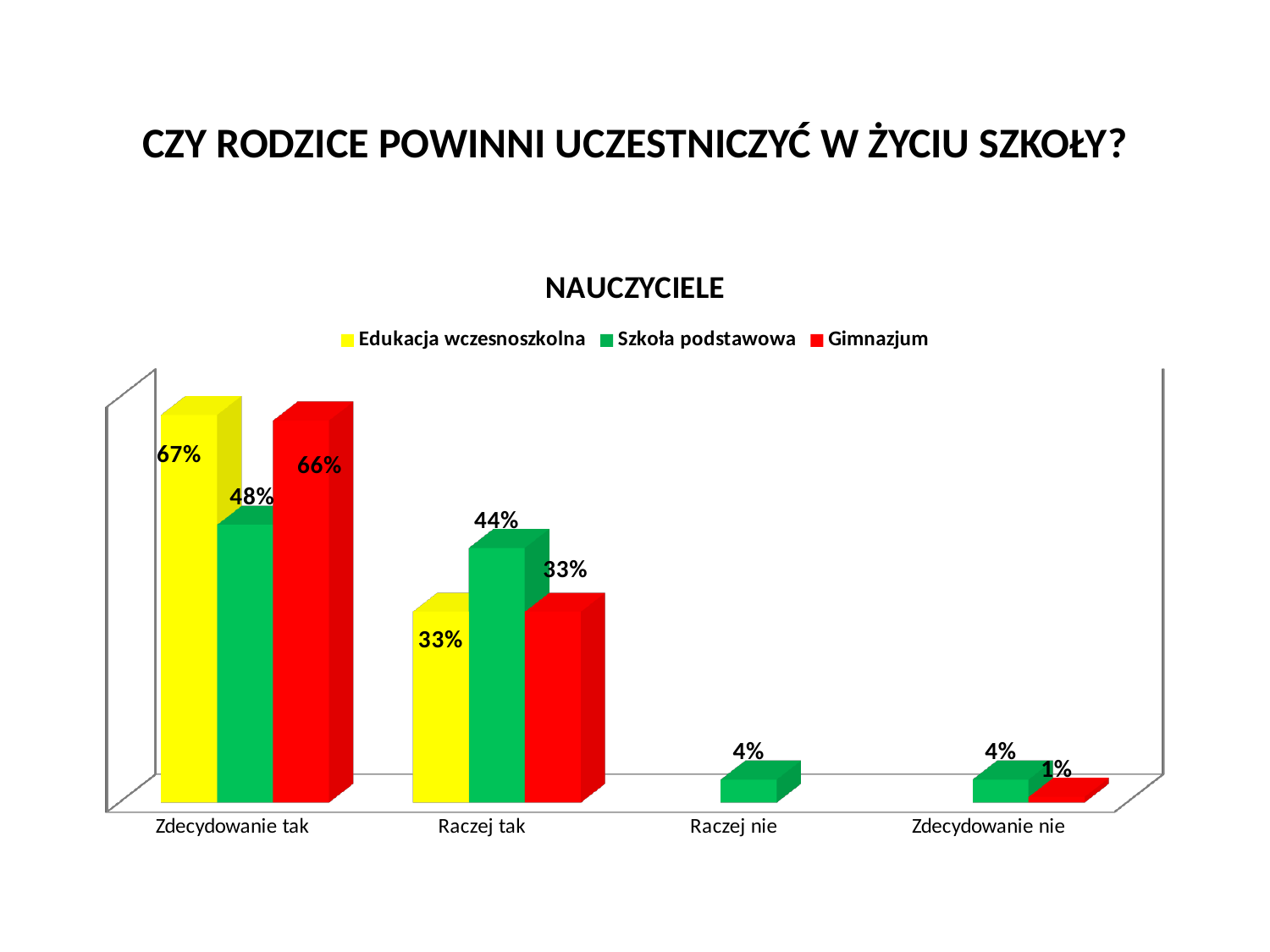
What is the value for Szkoła podstawowa in the Zdecydowanie tak category? 48% What kind of chart is shown on the slide? bar chart How many series does the legend list? 3 How many categories are shown on the x axis? 4 What is the value for Gimnazjum in the Zdecydowanie nie category? 1% In the Raczej tak category, which is larger: Szkoła podstawowa or Gimnazjum? Szkoła podstawowa Which category has the highest value for Szkoła podstawowa? Zdecydowanie tak What is the difference between the Edukacja wczesnoszkolna and Szkoła podstawowa values in the Zdecydowanie tak category? 19% What is the value for Edukacja wczesnoszkolna in the Zdecydowanie tak category? 67% What is the title of the chart? NAUCZYCIELE What is the value for Gimnazjum in the Raczej tak category? 33%